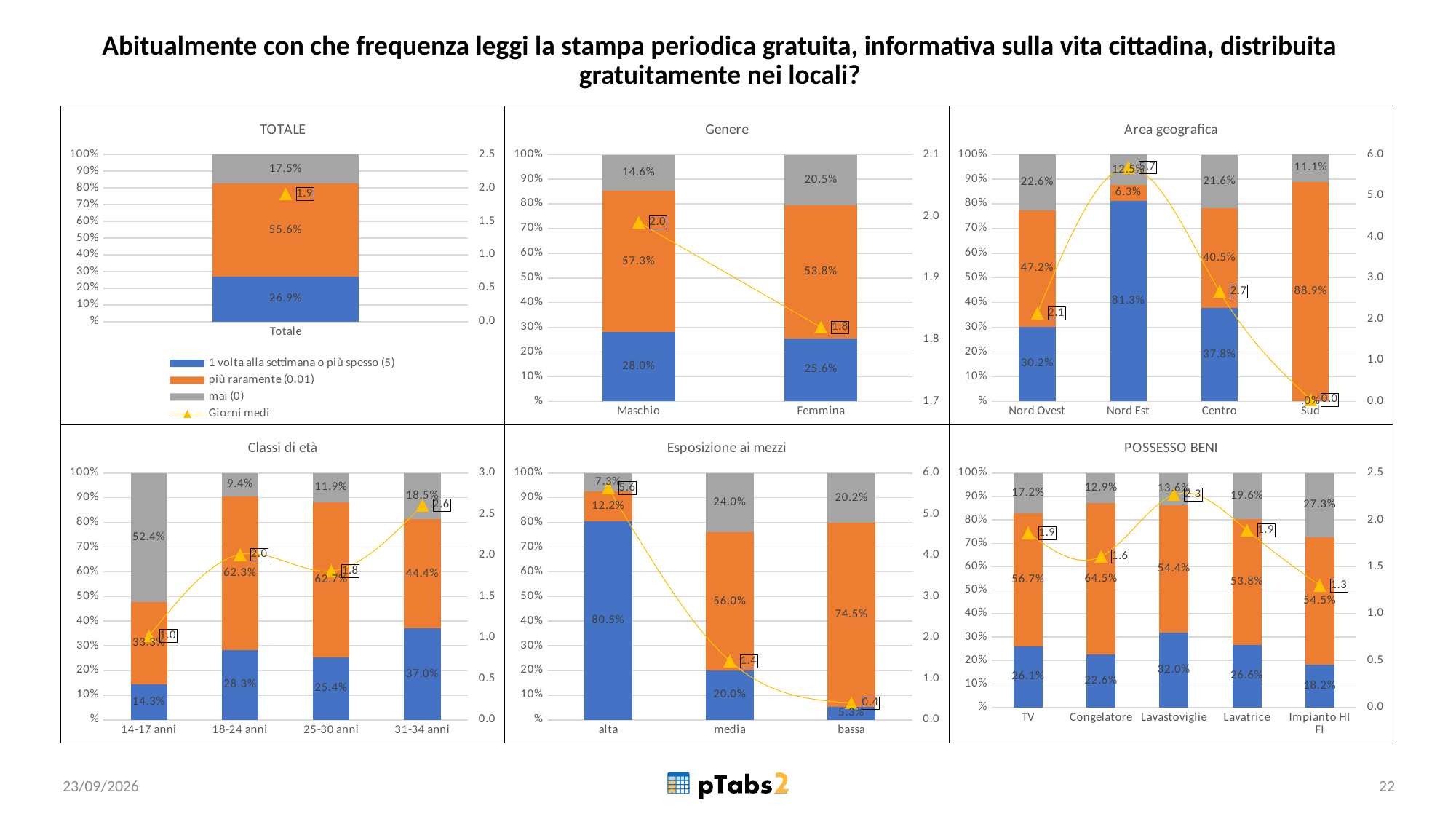
In the POSSESSO BENI chart, which is larger: the '1 volta alla settimana o più spesso (5)' share for Lavastoviglie or for Impianto HI FI? Lavastoviglie In the Area geografica chart, which category has the highest 'Giorni medi' value? Nord Est In the Esposizione ai mezzi chart, which category has the lowest 'Giorni medi' value? bassa In the Classi di età chart, what is the difference between the 'mai (0)' share for 14-17 anni and for 18-24 anni? 43.0% In the Genere chart, what is the 'Giorni medi' value for Maschio? 2.0 How many series does the legend in the TOTALE chart list? 4 In the Classi di età chart, how many age categories are shown? 4 In the POSSESSO BENI chart, what is the 'Giorni medi' value for Congelatore? 1.6 In the TOTALE chart, what is the value for 'più raramente (0.01)'? 55.6% In the Esposizione ai mezzi chart, what is the 'più raramente (0.01)' share for media? 56.0% In the Genere chart, what is the 'mai (0)' share for Femmina? 20.5% In the Area geografica chart, what is the '1 volta alla settimana o più spesso (5)' share for Nord Est? 81.3%